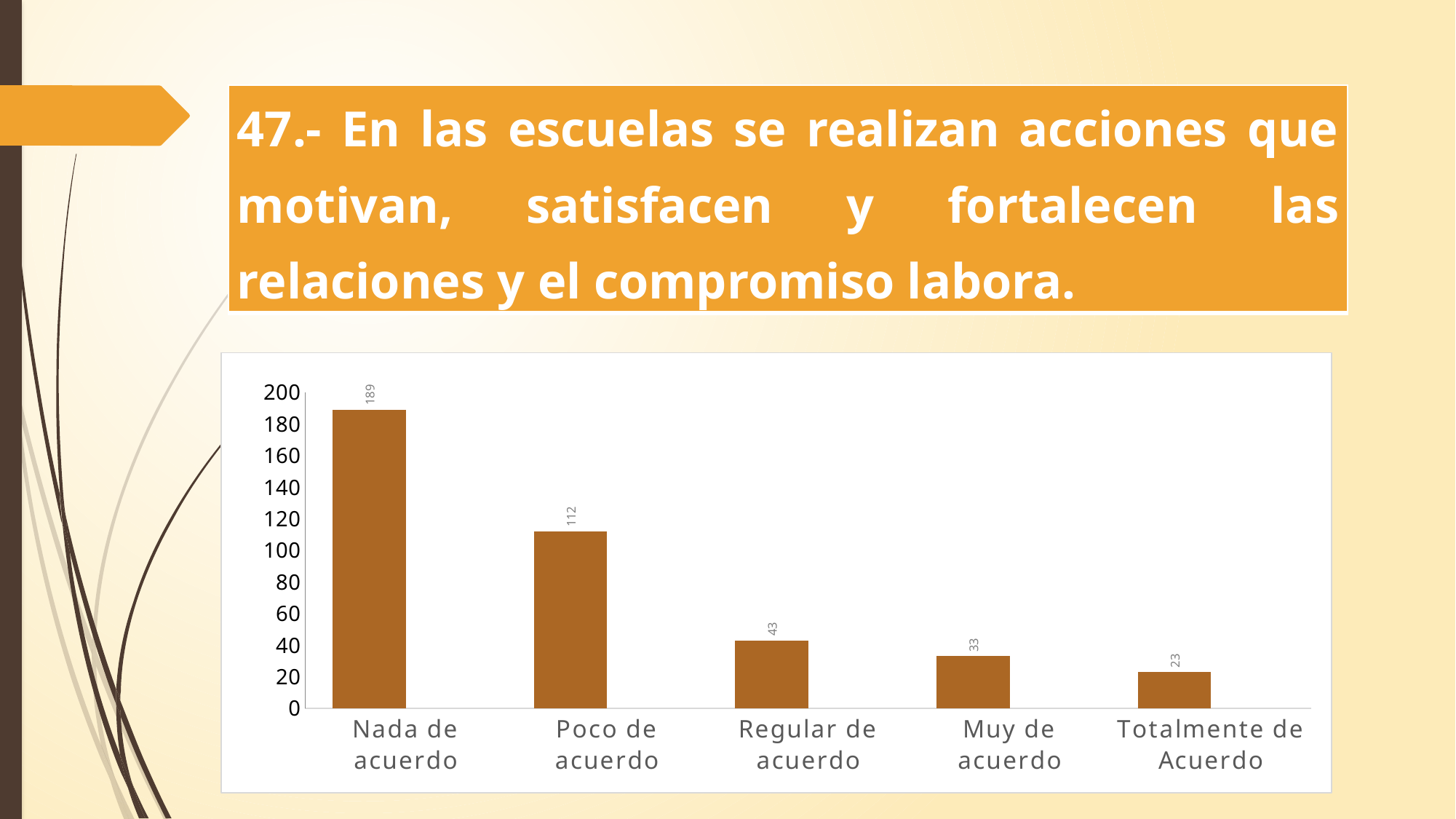
Which category has the highest value? Nada de acuerdo Which category has the lowest value? Totalmente de Acuerdo What is the value for "Poco de acuerdo"? 112 How many categories are shown on the x axis? 5 What kind of chart is shown on the slide? Bar chart What is the value for "Totalmente de Acuerdo"? 23 Which is larger, the value for "Regular de acuerdo" or the value for "Muy de acuerdo"? Regular de acuerdo What is the value for "Regular de acuerdo"? 43 What is the value for "Muy de acuerdo"? 33 What is the difference between the values for "Nada de acuerdo" and "Poco de acuerdo"? 77 Do the values rise or fall from left to right along the x axis? Fall What is the value for "Nada de acuerdo"? 189